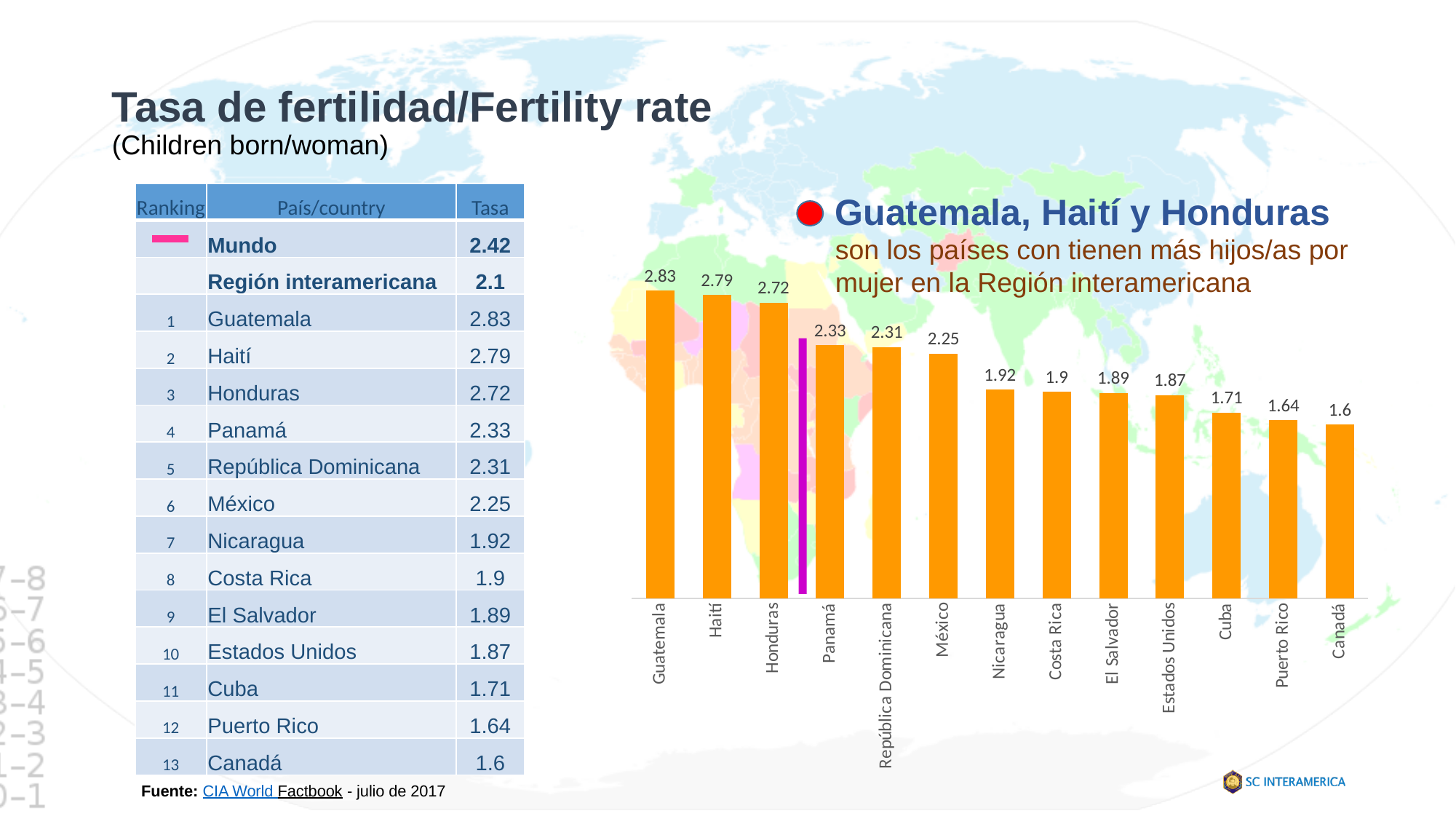
Which has a higher fertility rate in the bar chart, Haití or Honduras? Haití Which has a higher fertility rate in the bar chart, Cuba or Puerto Rico? Cuba What is the fertility rate shown for Costa Rica in the bar chart? 1.9 Which country has the highest fertility rate in the bar chart? Guatemala Which country has the lowest fertility rate in the bar chart? Canadá What kind of chart is used to show the fertility rates? Bar chart How many countries are plotted in the bar chart? 13 Do the fertility rate values rise or fall from left to right across the bar chart? Fall What is the fertility rate shown for Estados Unidos in the bar chart? 1.87 What is the difference between the fertility rates of Guatemala and Canadá in the bar chart? 1.23 What is the difference between the fertility rates of Panamá and México in the bar chart? 0.08 What is the fertility rate shown for Guatemala in the bar chart? 2.83